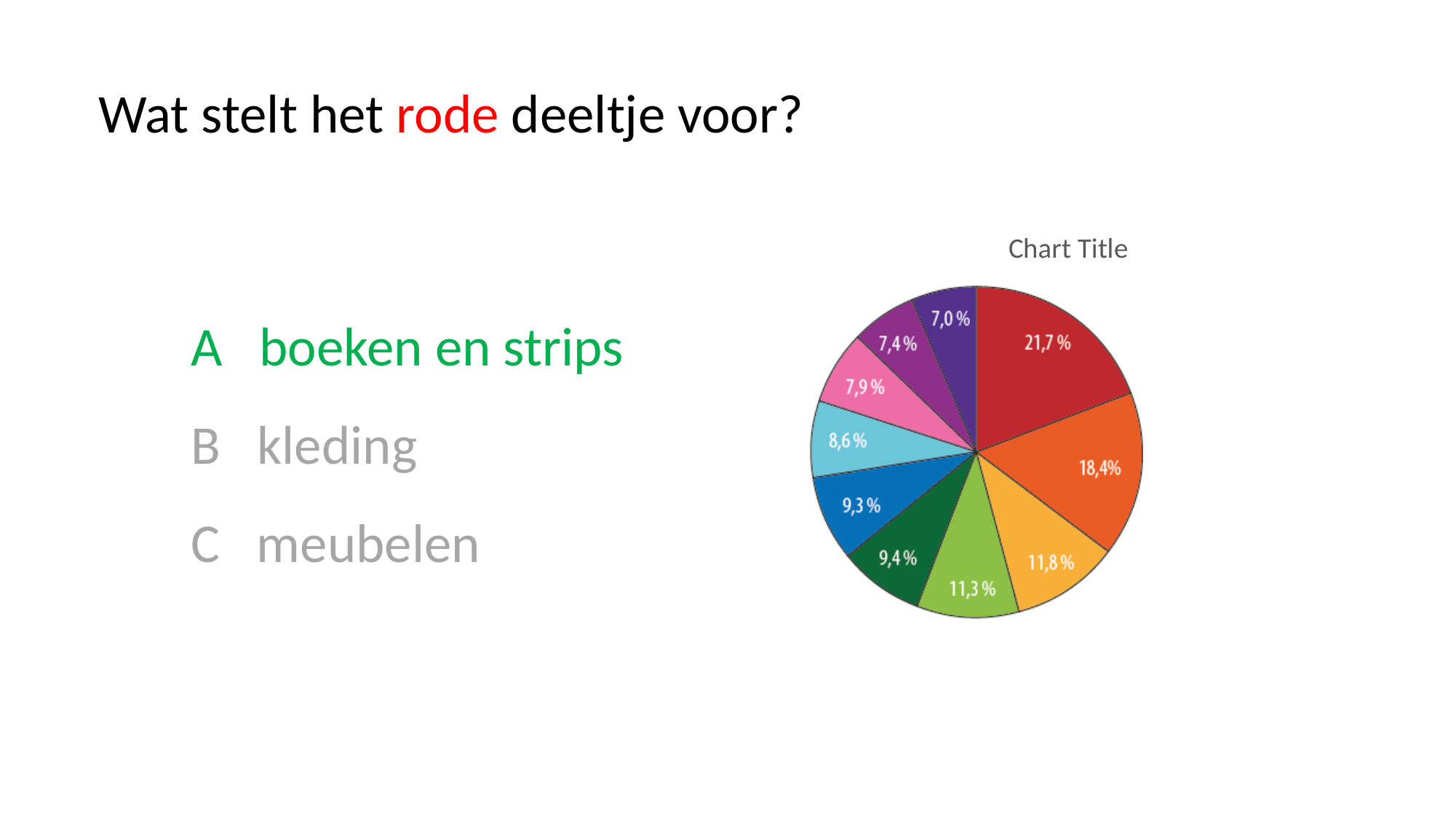
What percentage is shown on the orange slice of the pie chart? 18,4% What is the difference between the red slice and the orange slice of the pie chart? 3,3 % What is the difference between the pink slice and the dark purple slice of the pie chart? 0,9 % What percentage is shown on the red slice of the pie chart? 21,7 % Which is larger in the pie chart: the yellow slice or the light green slice? the yellow slice (11,8 %) How many slices does the pie chart have? 10 Which slice of the pie chart has the smallest share? the dark purple slice (7,0 %) What kind of chart is shown on the slide? pie chart Which slice of the pie chart has the largest share? the red slice (21,7 %) What percentage is shown on the light blue slice of the pie chart? 8,6 % According to the slide, what does the red slice of the pie chart represent? boeken en strips What is the title shown above the pie chart? Chart Title